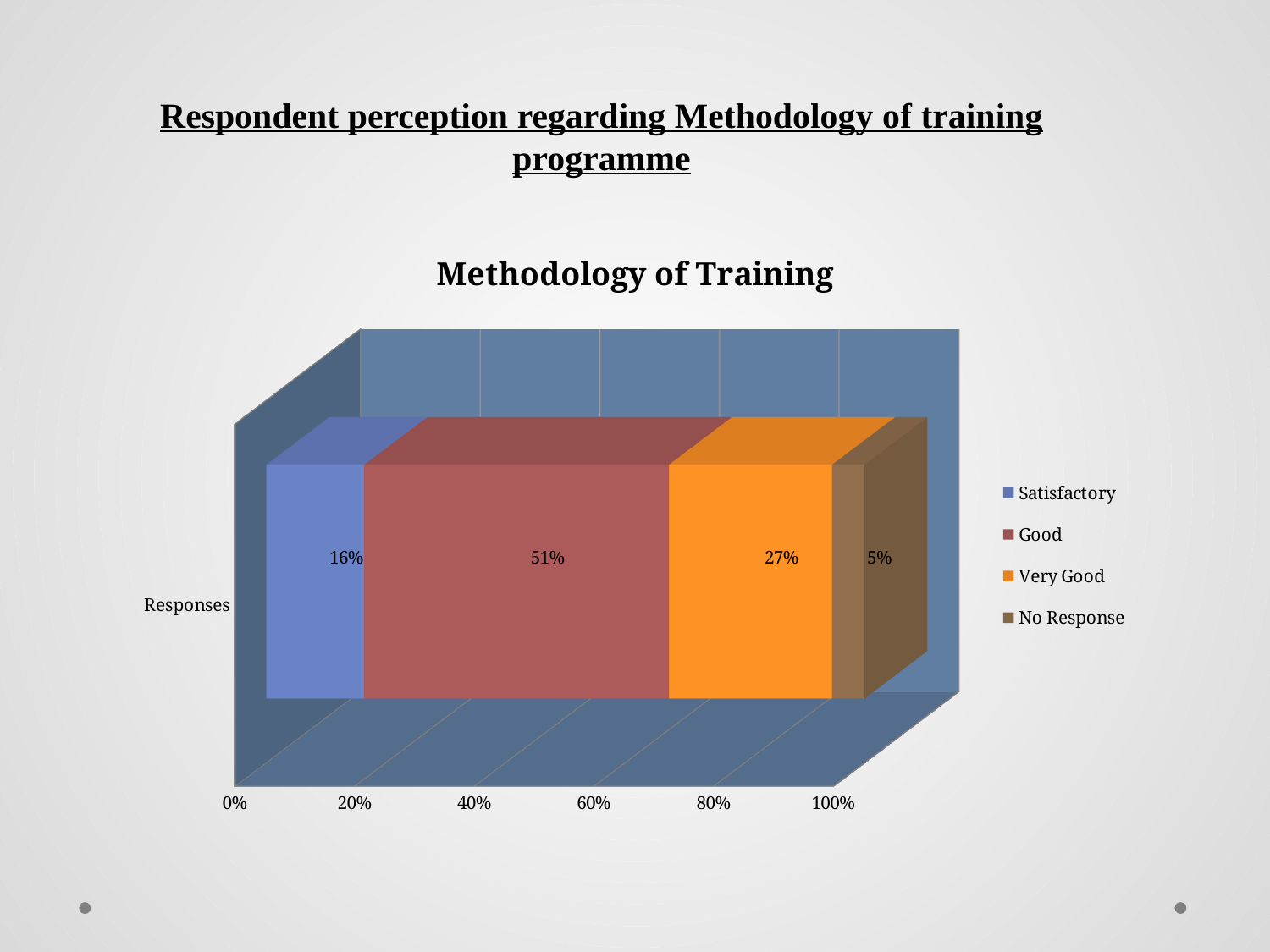
What percentage of responses rated the methodology of training as Satisfactory? 16% What percentage of responses rated the methodology of training as Very Good? 27% Which is larger, the Satisfactory share or the Very Good share? Very Good What is the difference between the Good and Very Good percentages? 24% What percentage of responses rated the methodology of training as Good? 51% How many series does the legend list? 4 Which response category has the highest share? Good What is the total of the stacked bar for Responses? 99% What percentage of responses fall under No Response? 5% What is the title of the chart? Methodology of Training Which response category has the lowest share? No Response What kind of chart is shown on the slide? Stacked bar chart